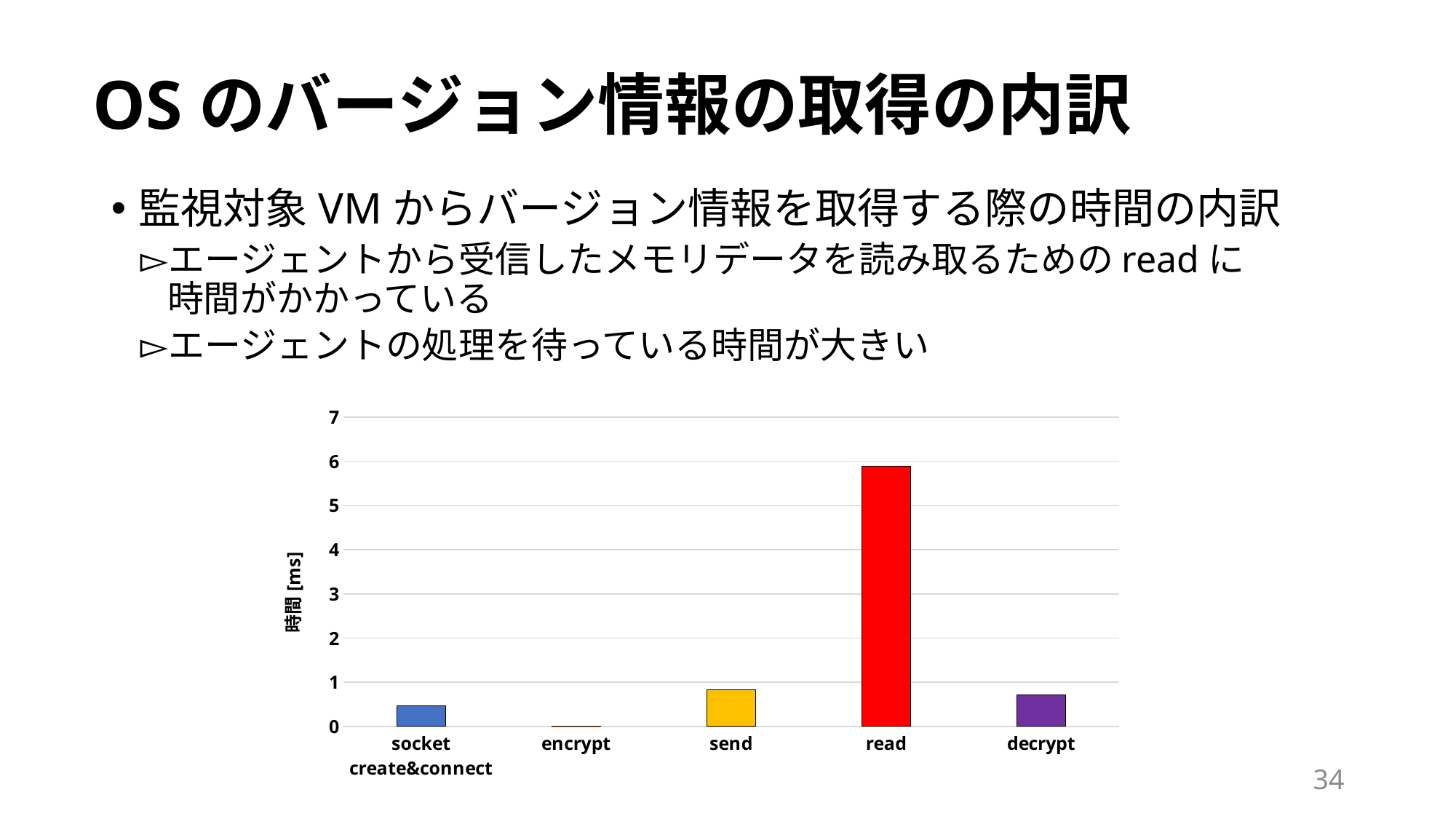
Is the value for read greater or less than 5? greater What is the label of the y axis of the chart? 時間 [ms] Is the value for read greater or less than 6? less Which category has the highest value in the chart? read How many categories are shown on the x axis of the chart? 5 Which is larger, the value for encrypt or the value for decrypt? decrypt Is the value for send greater or less than 1? less Which is larger, the value for decrypt or the value for socket create&connect? decrypt Which category has the lowest value in the chart? encrypt Which is larger, the value for read or the value for send? read What kind of chart is shown on the slide? bar chart